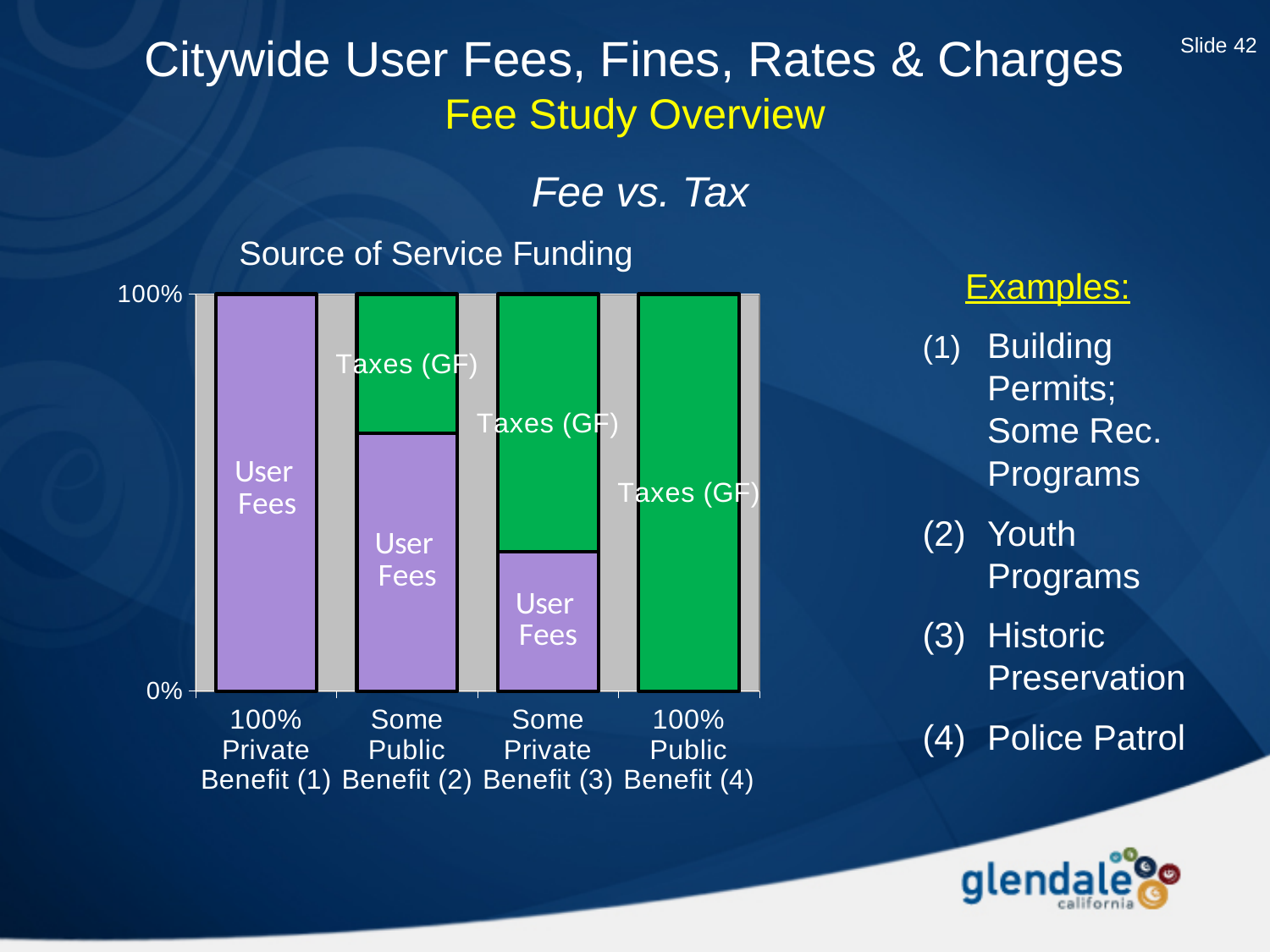
What share of funding comes from Taxes (GF) for 100% Public Benefit (4)? 100% Does the User Fees share rise or fall moving from left to right across the categories? Fall Which category has the largest Taxes (GF) share? 100% Public Benefit (4) For Some Public Benefit (2), which is larger, User Fees or Taxes (GF)? User Fees For Some Private Benefit (3), which is larger, User Fees or Taxes (GF)? Taxes (GF) Which category has the largest User Fees share? 100% Private Benefit (1) What share of funding comes from User Fees for 100% Private Benefit (1)? 100% How many categories are shown on the x axis of the chart? 4 What kind of chart is shown on the slide? Stacked bar chart What is the title of the chart? Source of Service Funding Which category has the smallest User Fees share? 100% Public Benefit (4) Does the Taxes (GF) share rise or fall moving from left to right across the categories? Rise